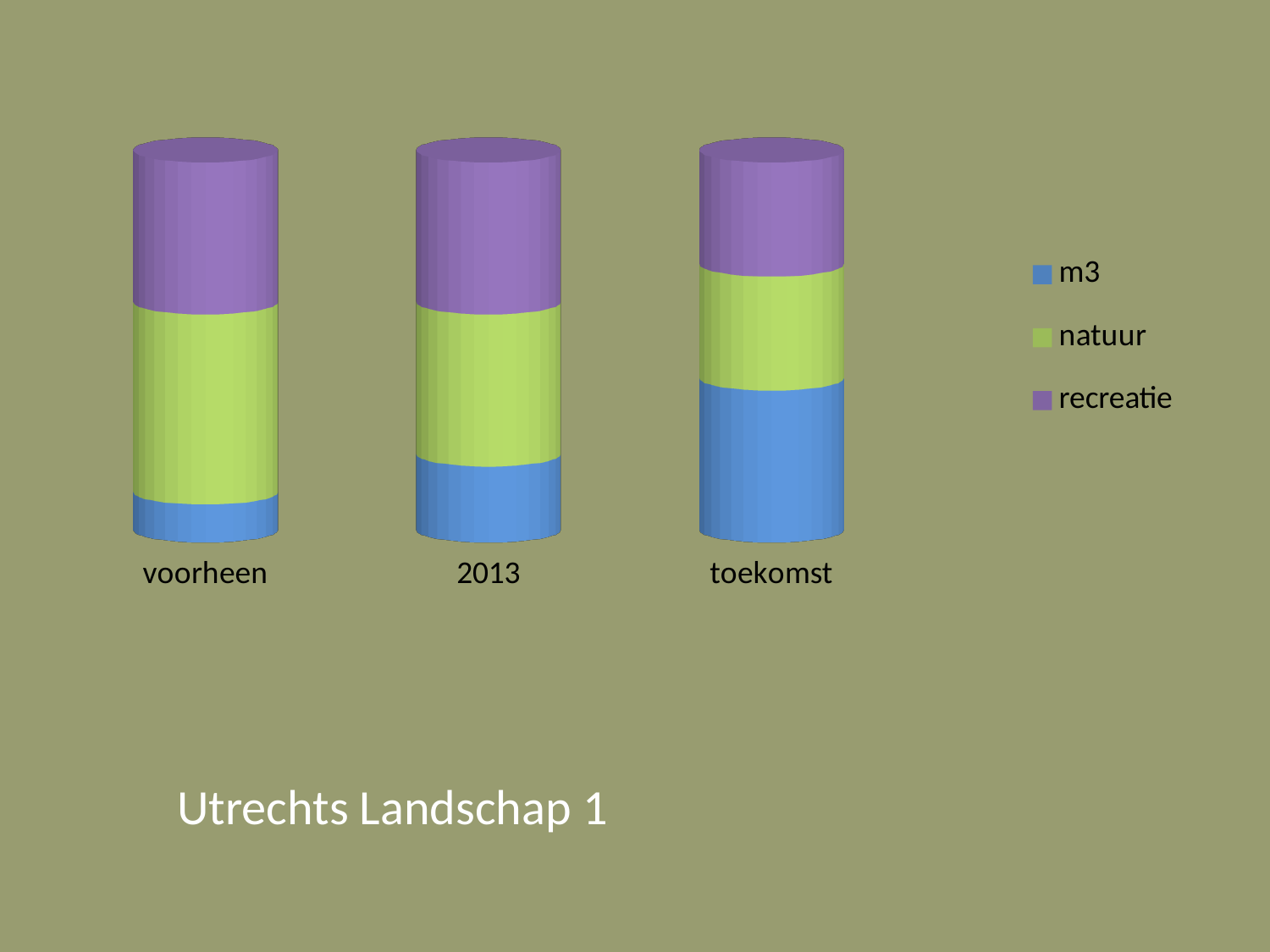
Which category has the smallest m3 segment? voorheen How many series does the legend list? 3 Does the recreatie segment rise or fall from 2013 to toekomst? fall In the voorheen bar, which segment is larger: m3 or natuur? natuur What kind of chart is shown on the slide? stacked bar chart Which category has the largest m3 segment? toekomst Which series are listed in the legend? m3, natuur, recreatie Does the natuur segment rise or fall from voorheen to toekomst? fall Does the m3 segment rise or fall from voorheen to toekomst? rise How many categories are shown along the x axis? 3 Which colour represents the m3 series? blue Which category has the smallest recreatie segment? toekomst